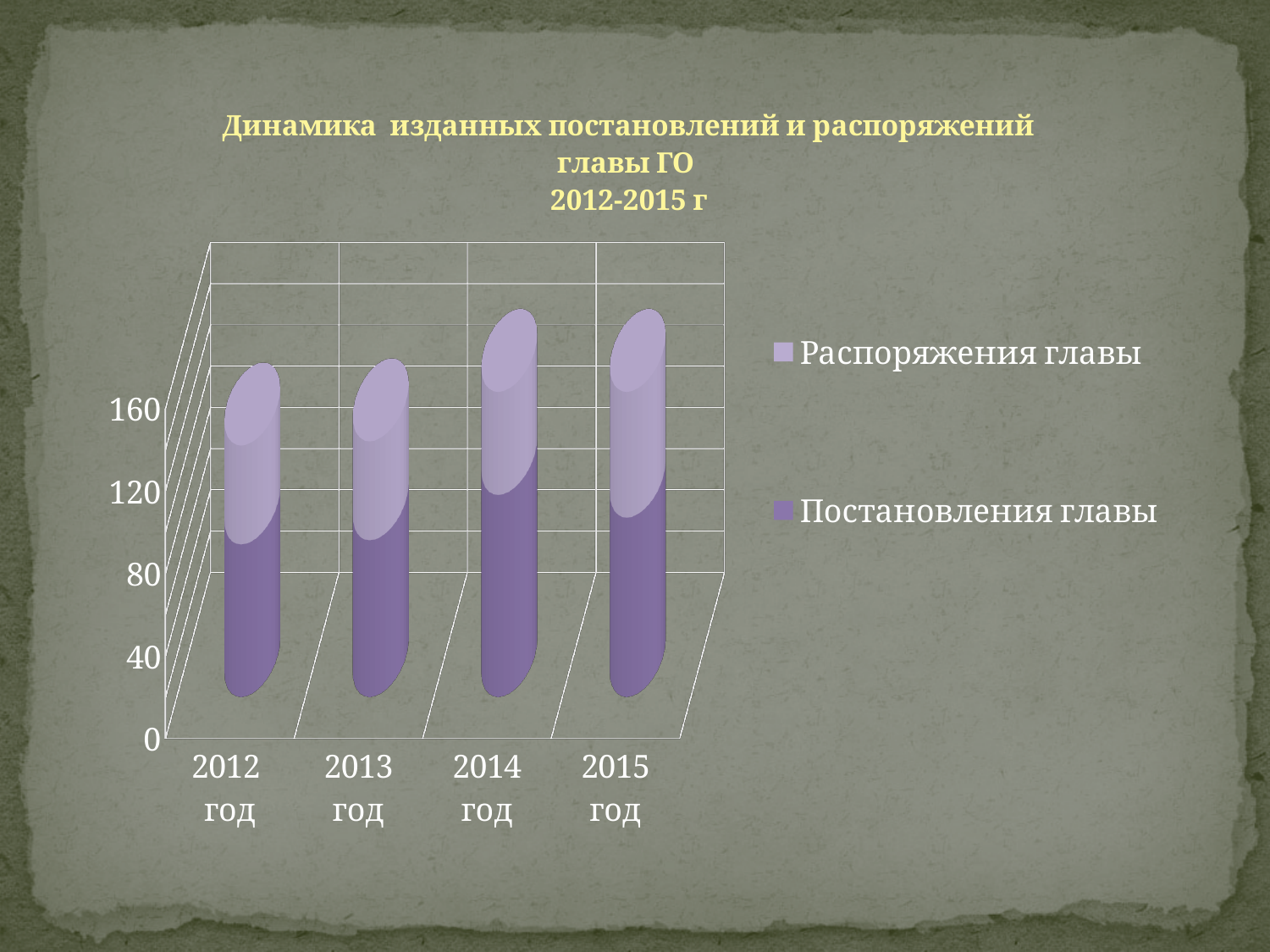
Do the total bar heights generally rise or fall from 2012 год to 2015 год? Rise How many years (categories) are shown on the x axis of the chart? 4 How many series does the chart legend list? 2 Which series is shown in the darker purple colour at the bottom of each bar? Постановления главы What kind of chart is shown on the slide? Stacked bar chart Is the total value for 2014 год greater or less than 40? greater Which is larger: the total bar for 2014 год or the total bar for 2012 год? 2014 год What are the two series named in the chart legend? Распоряжения главы and Постановления главы Which is larger: the total bar for 2015 год or the total bar for 2013 год? 2015 год What period does the chart title say the data covers? 2012-2015 г Which is larger: the Постановления главы segment for 2014 год or for 2012 год? 2014 год